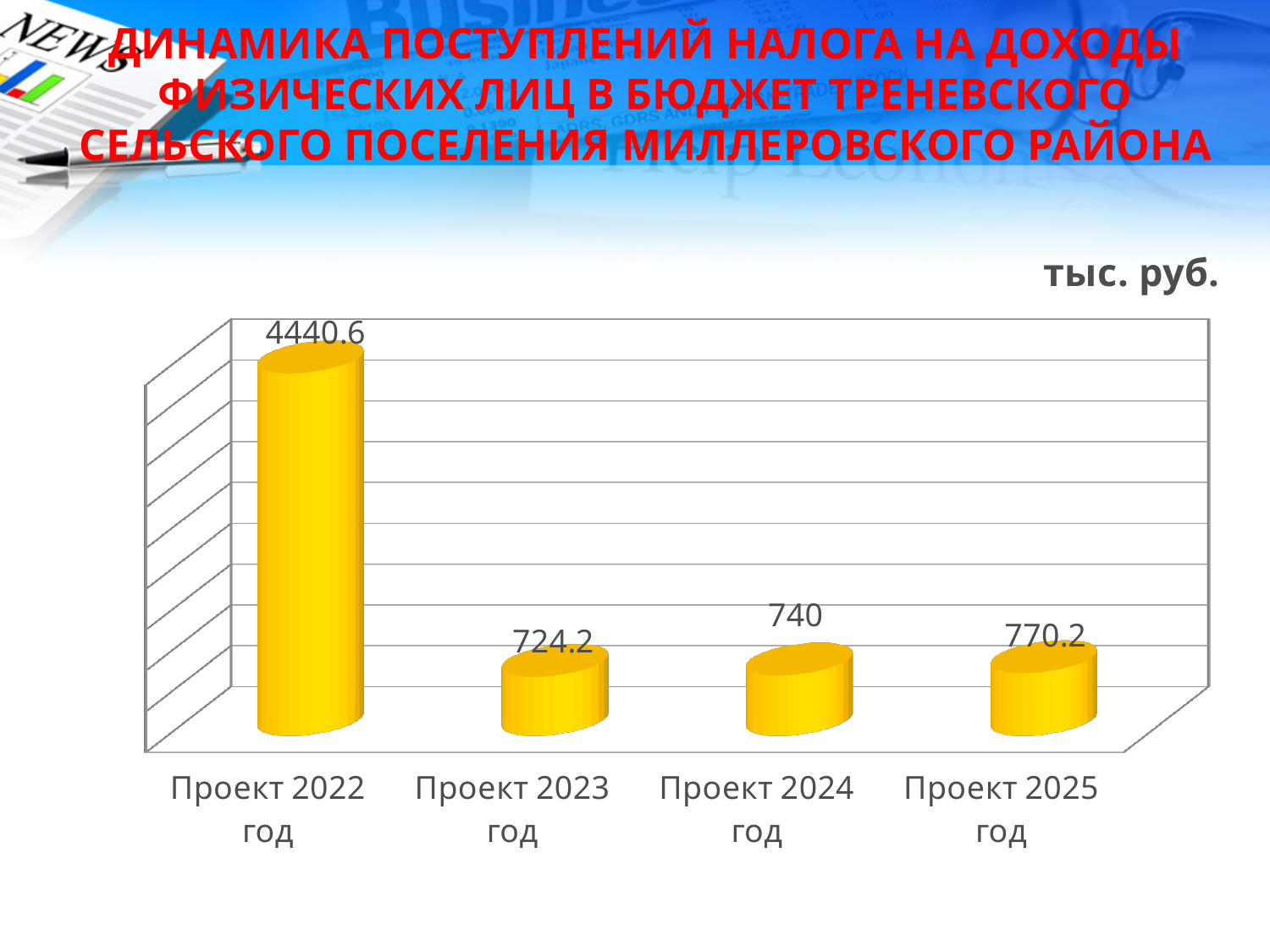
What is the value for Проект 2022 год? 4440.6 Which category has the highest value? Проект 2022 год What kind of chart is shown on the slide? Bar chart What is the value for Проект 2024 год? 740 What is the value for Проект 2023 год? 724.2 What is the value for Проект 2025 год? 770.2 What is the difference between the values for Проект 2025 год and Проект 2024 год? 30.2 How many categories are shown on the chart? 4 In what units are the chart values given? тыс. руб. Which is larger, the value for Проект 2024 год or Проект 2023 год? Проект 2024 год Which category has the lowest value? Проект 2023 год What is the difference between the values for Проект 2022 год and Проект 2023 год? 3716.4